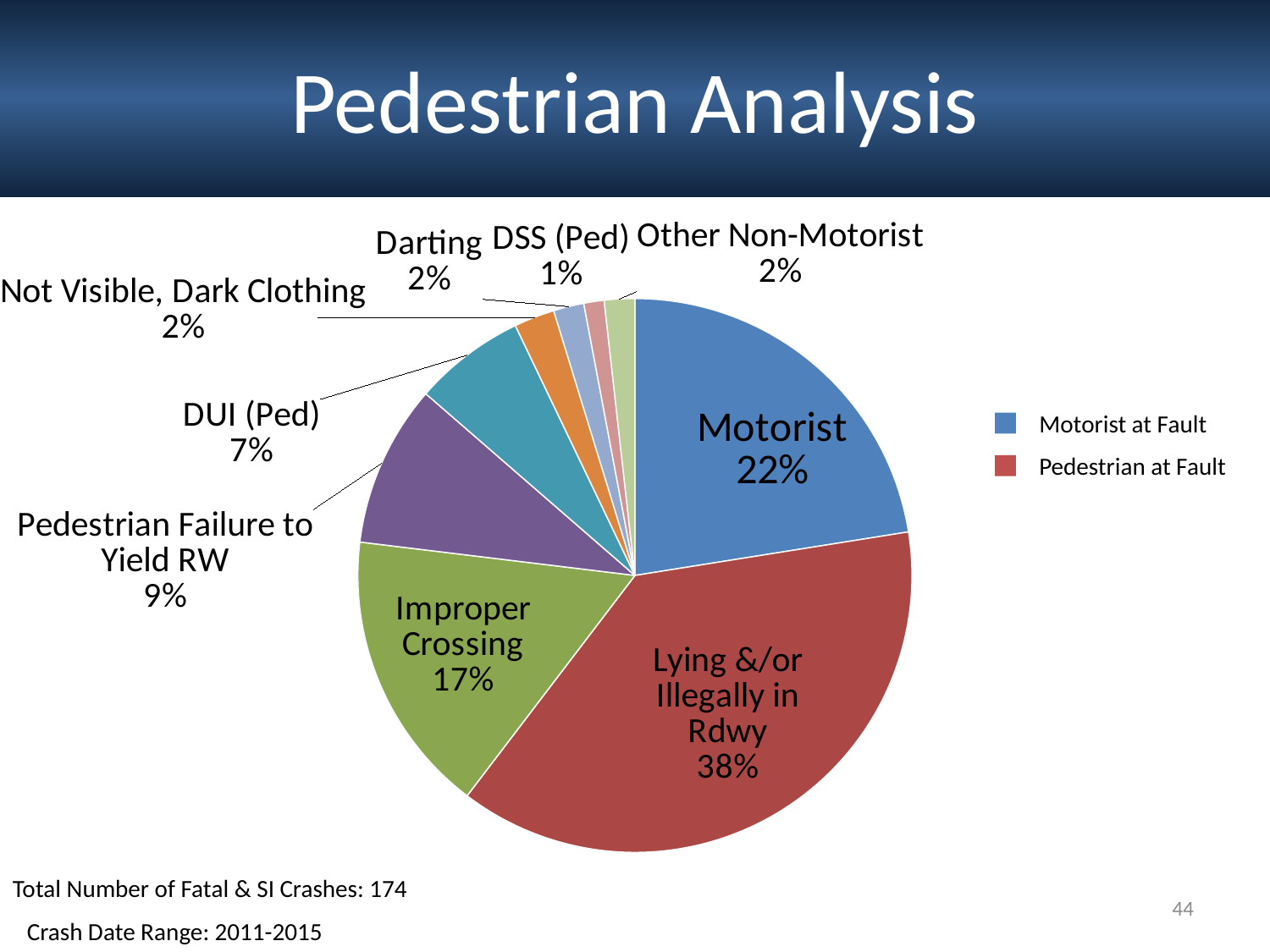
Which category has the smallest slice of the pie? DSS (Ped) What percentage is shown for the Motorist slice? 22% How many entries does the legend list? 2 What is the difference in percentage points between Lying &/or Illegally in Rdwy and Motorist? 16 What percentage is shown for DUI (Ped)? 7% What percentage is shown for Improper Crossing? 17% What share of the pie does the Lying &/or Illegally in Rdwy slice represent? 38% How many slices does the pie chart have? 9 What type of chart is shown on the slide? Pie chart What percentage is shown for Pedestrian Failure to Yield RW? 9% Which category has the largest slice of the pie? Lying &/or Illegally in Rdwy Which is larger, the Improper Crossing slice or the Pedestrian Failure to Yield RW slice? Improper Crossing